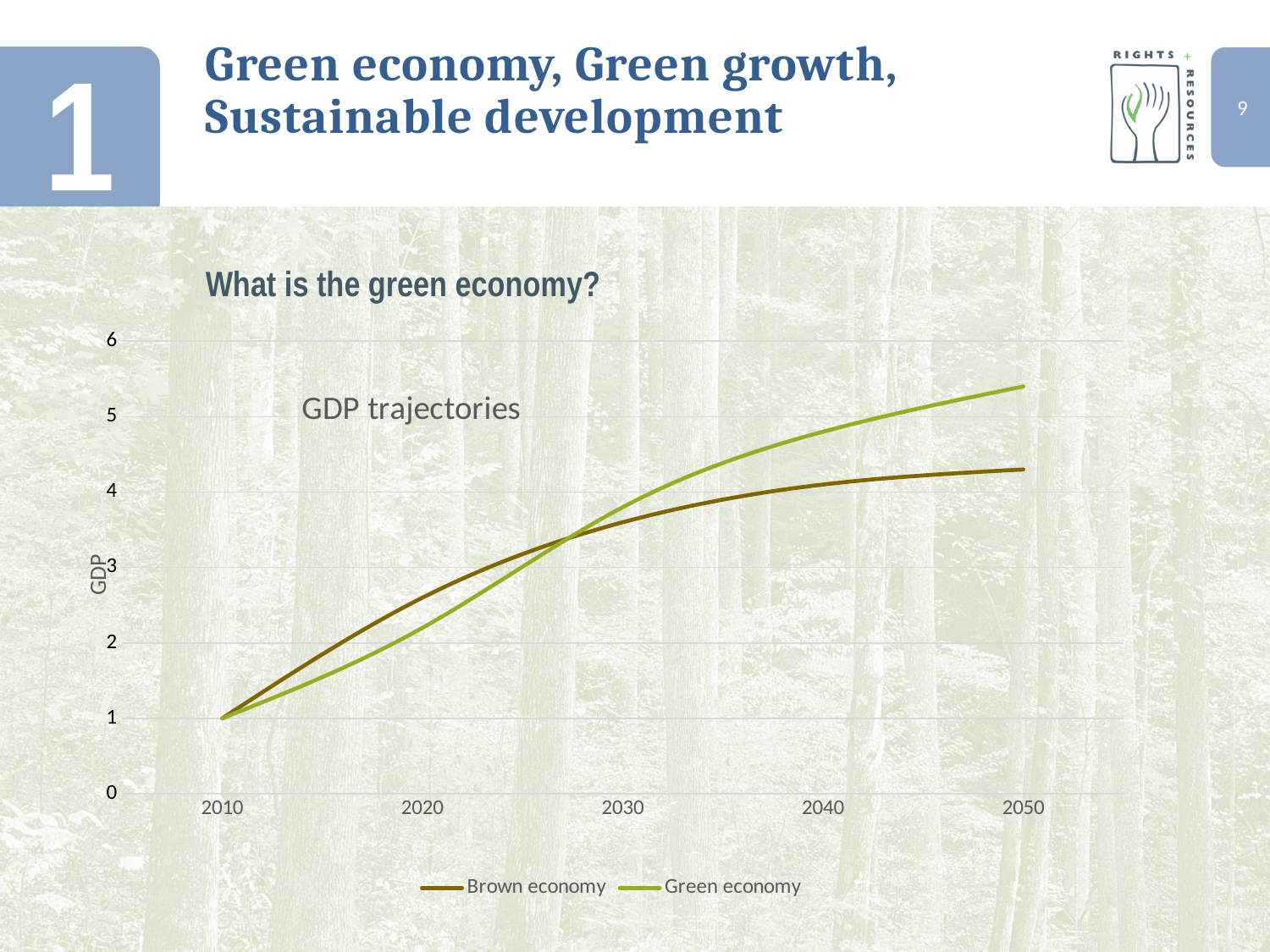
Does the Brown economy line rise or fall from 2010 to 2050? rise How many year labels are shown on the x axis? 5 What are the two series named in the legend of the chart? Brown economy and Green economy Is the value for Brown economy in 2050 greater or less than 5? less What is the label of the vertical axis? GDP What is the title of the chart? GDP trajectories What kind of chart is shown on the slide? line chart Which series has the higher value in 2020, Brown economy or Green economy? Brown economy Does the Green economy line rise or fall from 2010 to 2050? rise Is the value for Green economy in 2050 greater or less than 5? greater Which series has the higher value in 2050, Brown economy or Green economy? Green economy How many series does the legend of the GDP trajectories chart list? 2